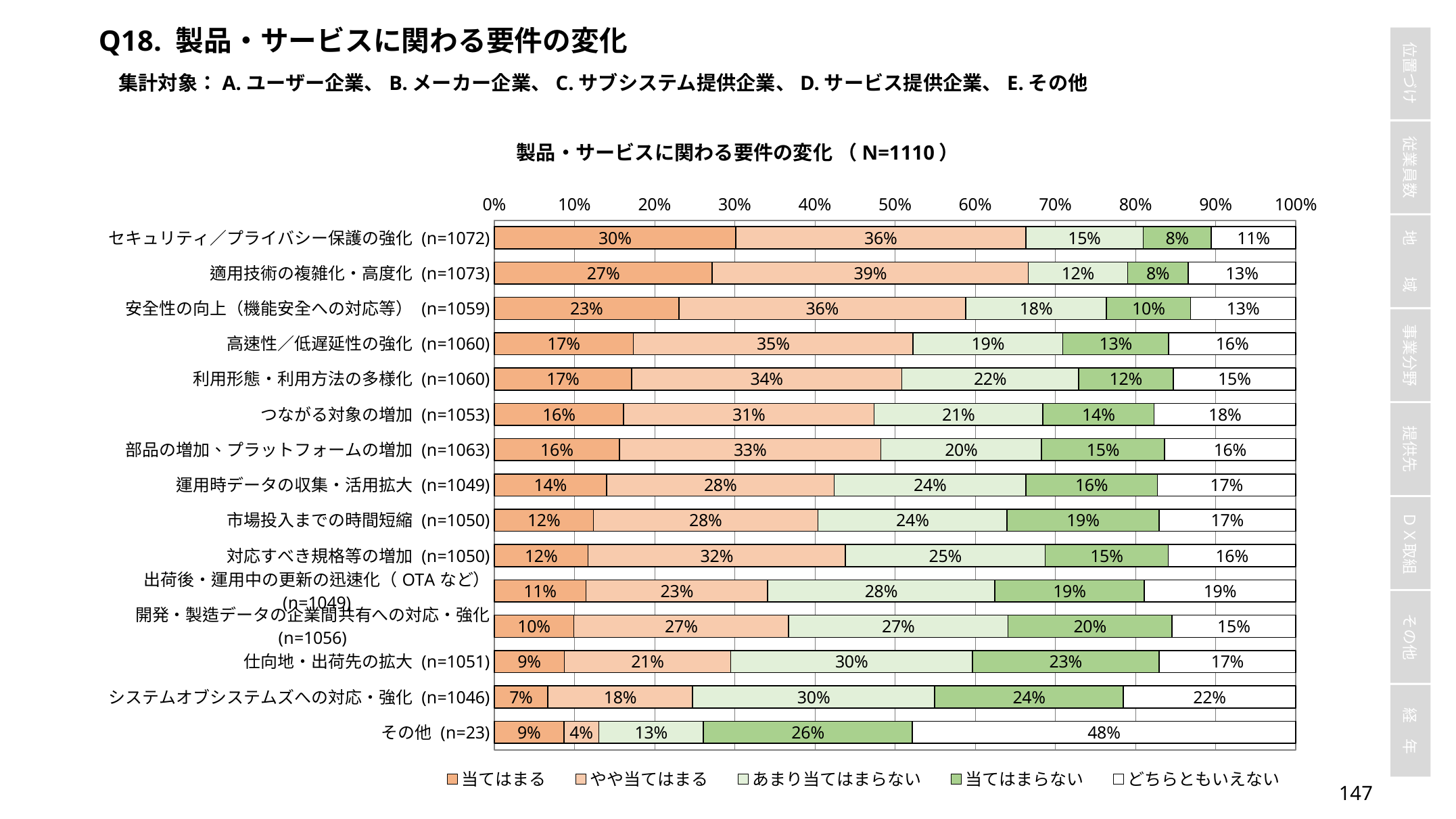
How many categories (rows) are plotted in the chart? 15 Which has the larger あまり当てはまらない value: 安全性の向上（機能安全への対応等） or 仕向地・出荷先の拡大? 仕向地・出荷先の拡大 What is the どちらともいえない value for その他 (n=23)? 48% What kind of chart is shown on the slide? Stacked horizontal bar chart Which category has the highest 当てはまる value? セキュリティ／プライバシー保護の強化 How many series does the legend list? 5 What is the difference between the 当てはまる values for セキュリティ／プライバシー保護の強化 and 適用技術の複雑化・高度化? 3 percentage points What is the やや当てはまる value for 適用技術の複雑化・高度化? 39% What is the N value shown in the chart title? N=1110 Which category has the lowest 当てはまる value? システムオブシステムズへの対応・強化 What is the 当てはまる value for セキュリティ／プライバシー保護の強化? 30% What is the combined share of 当てはまる and やや当てはまる for セキュリティ／プライバシー保護の強化? 66%